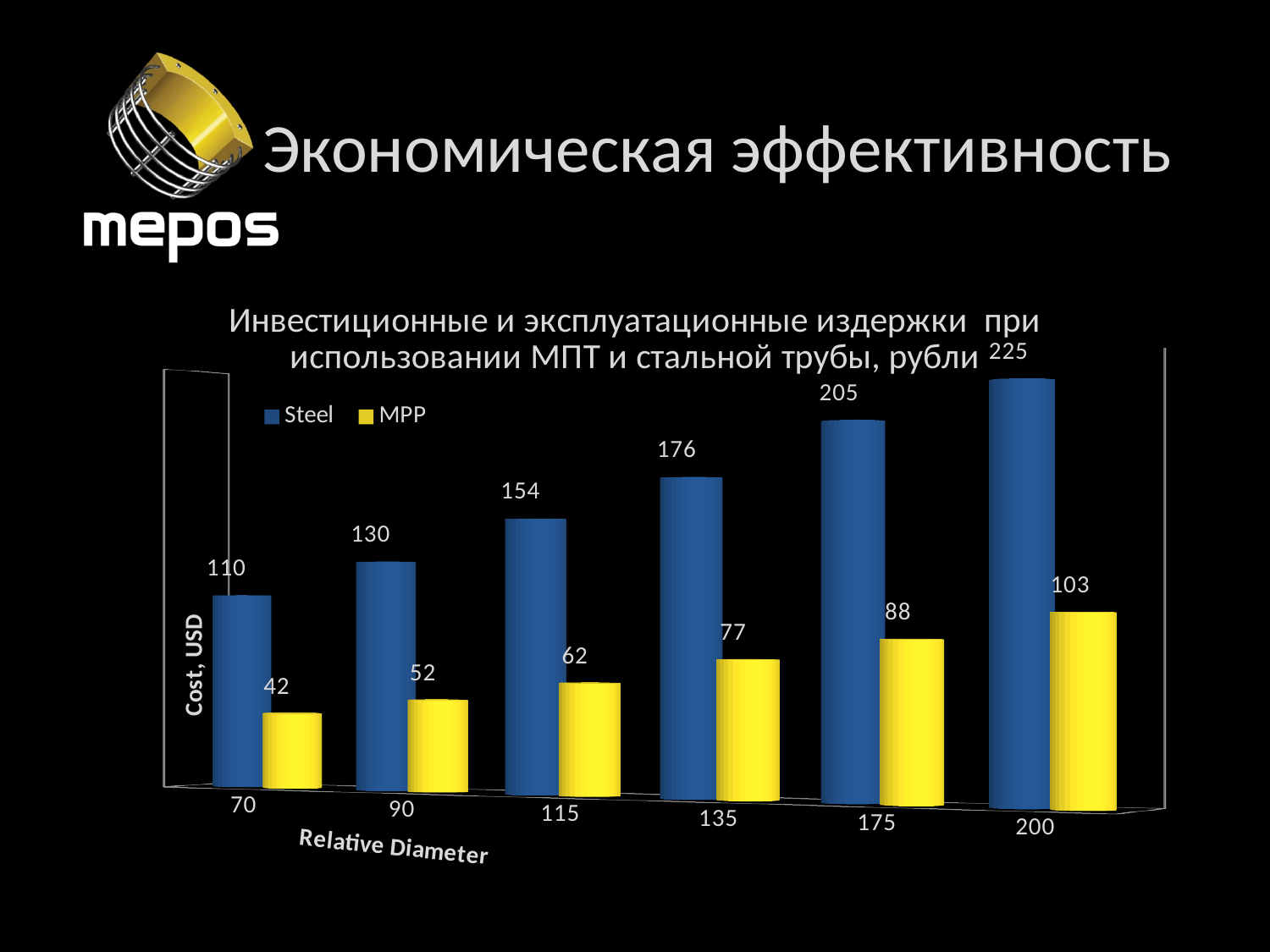
What is the MPP value at relative diameter 70? 42 At which relative diameter is the Steel value highest? 200 What is the MPP value at relative diameter 175? 88 At which relative diameter is the MPP value lowest? 70 How many series does the legend list? 2 How many relative diameter categories are shown on the x axis? 6 What kind of chart is shown on the slide? Bar chart Which is larger at relative diameter 90: the Steel value or the MPP value? Steel What is the Steel value at relative diameter 115? 154 What is the difference between the Steel and MPP values at relative diameter 135? 99 Do the MPP values rise or fall as relative diameter increases? Rise What is the difference between the Steel values at relative diameter 200 and 70? 115